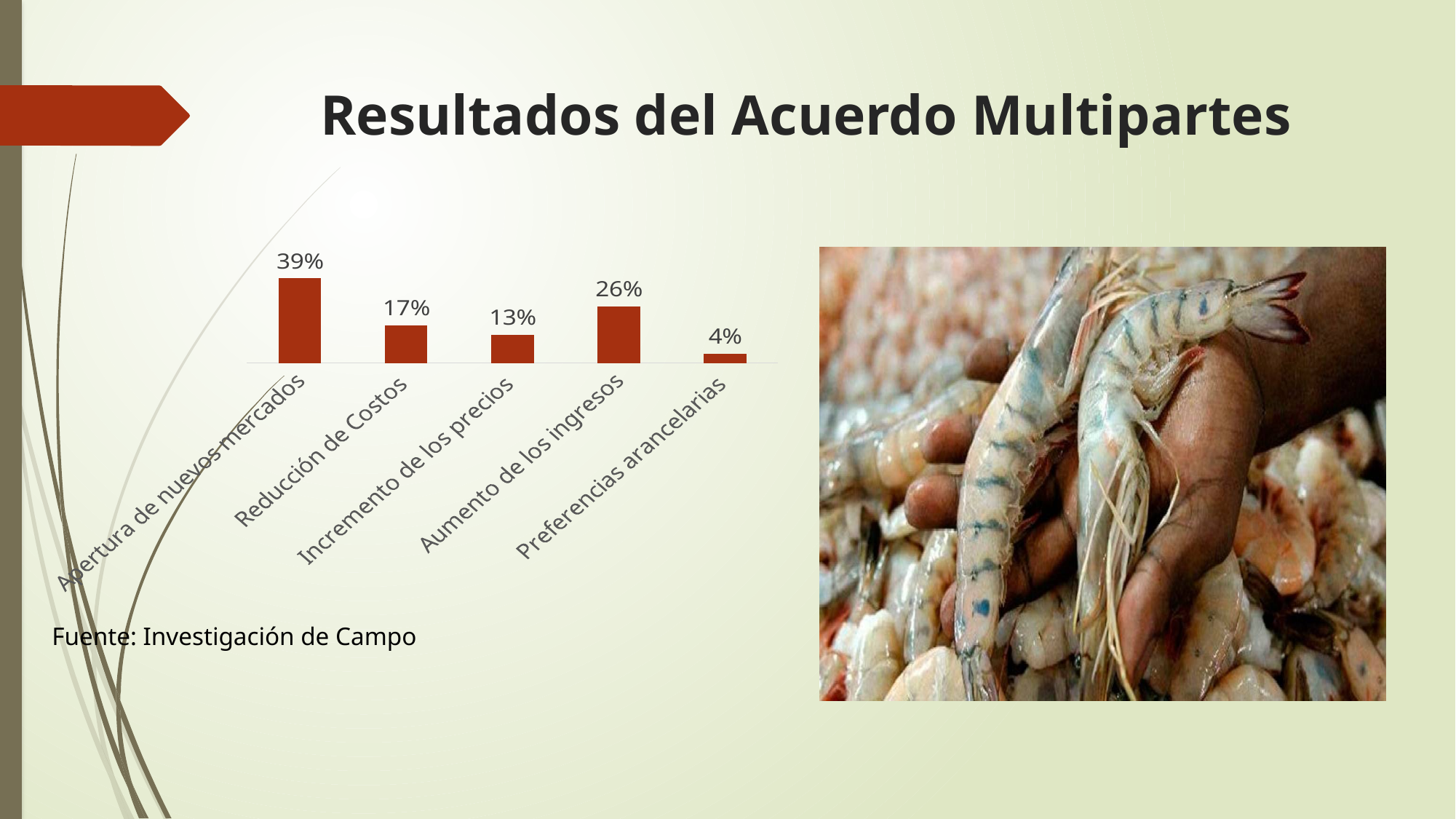
How many categories are shown in the chart? 5 What is the difference between the values for Apertura de nuevos mercados and Aumento de los ingresos? 13% Which category has the highest value? Apertura de nuevos mercados What is the source cited below the chart? Investigación de Campo Which is larger, the value for Reducción de Costos or the value for Incremento de los precios? Reducción de Costos What kind of chart is shown on the slide? Bar chart What is the value for Preferencias arancelarias? 4% What is the value for Reducción de Costos? 17% What is the value for Aumento de los ingresos? 26% Which category has the lowest value? Preferencias arancelarias What is the value for Incremento de los precios? 13% What is the value for Apertura de nuevos mercados? 39%